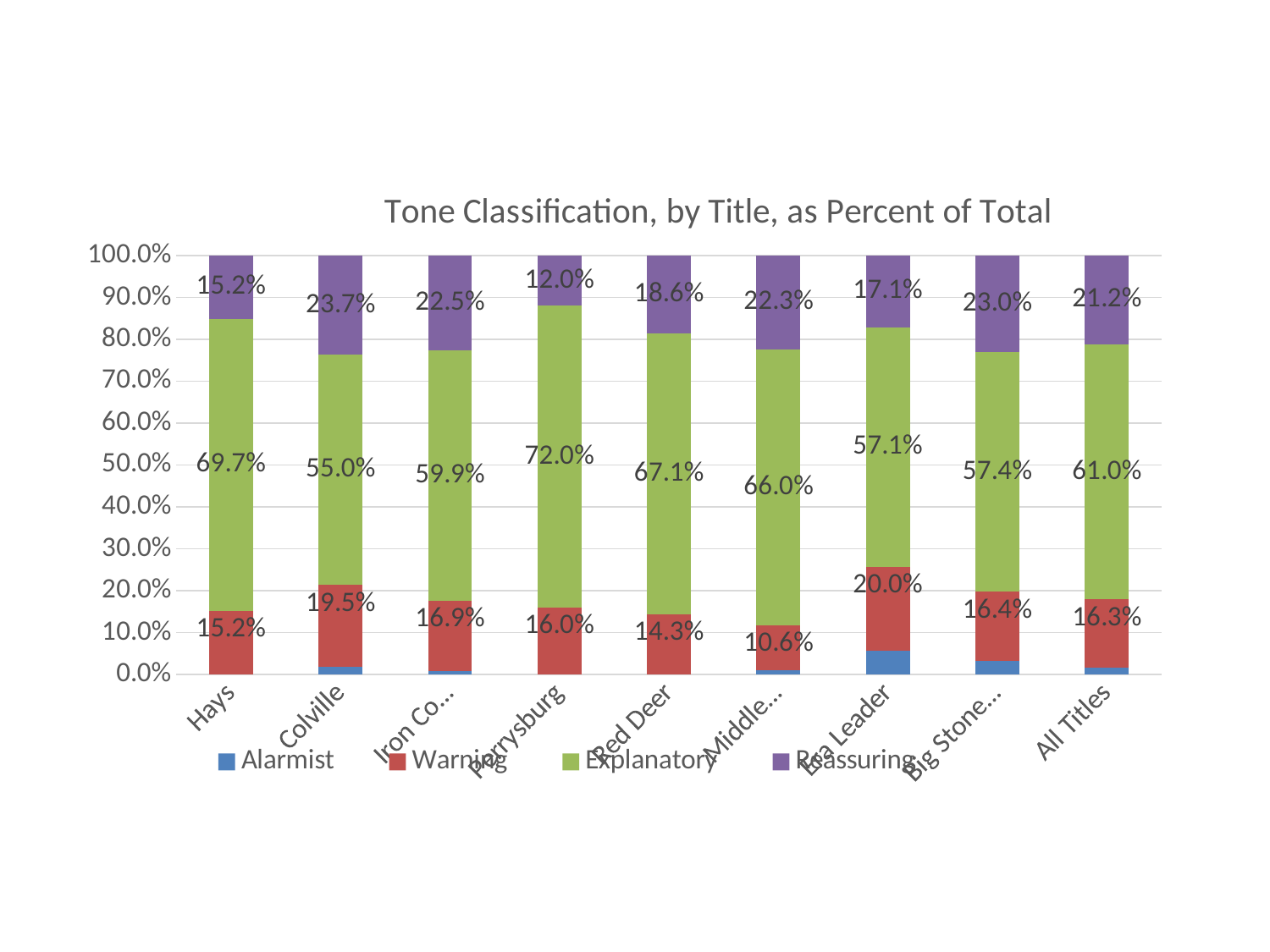
Which is larger, the Reassuring share for Hays or for Red Deer? Red Deer What is the Explanatory share for Perrysburg? 72.0% How many series does the legend list? 4 What is the difference between the Explanatory share for Perrysburg and for Colville? 17.0% What is the Warning share for Red Deer? 14.3% Which title has the highest Warning share? Era Leader Which title has the highest Explanatory share? Perrysburg What is the Explanatory share for All Titles? 61.0% What is the Reassuring share for Colville? 23.7% How many titles (categories) are shown on the x axis? 9 Which title has the lowest Reassuring share? Perrysburg